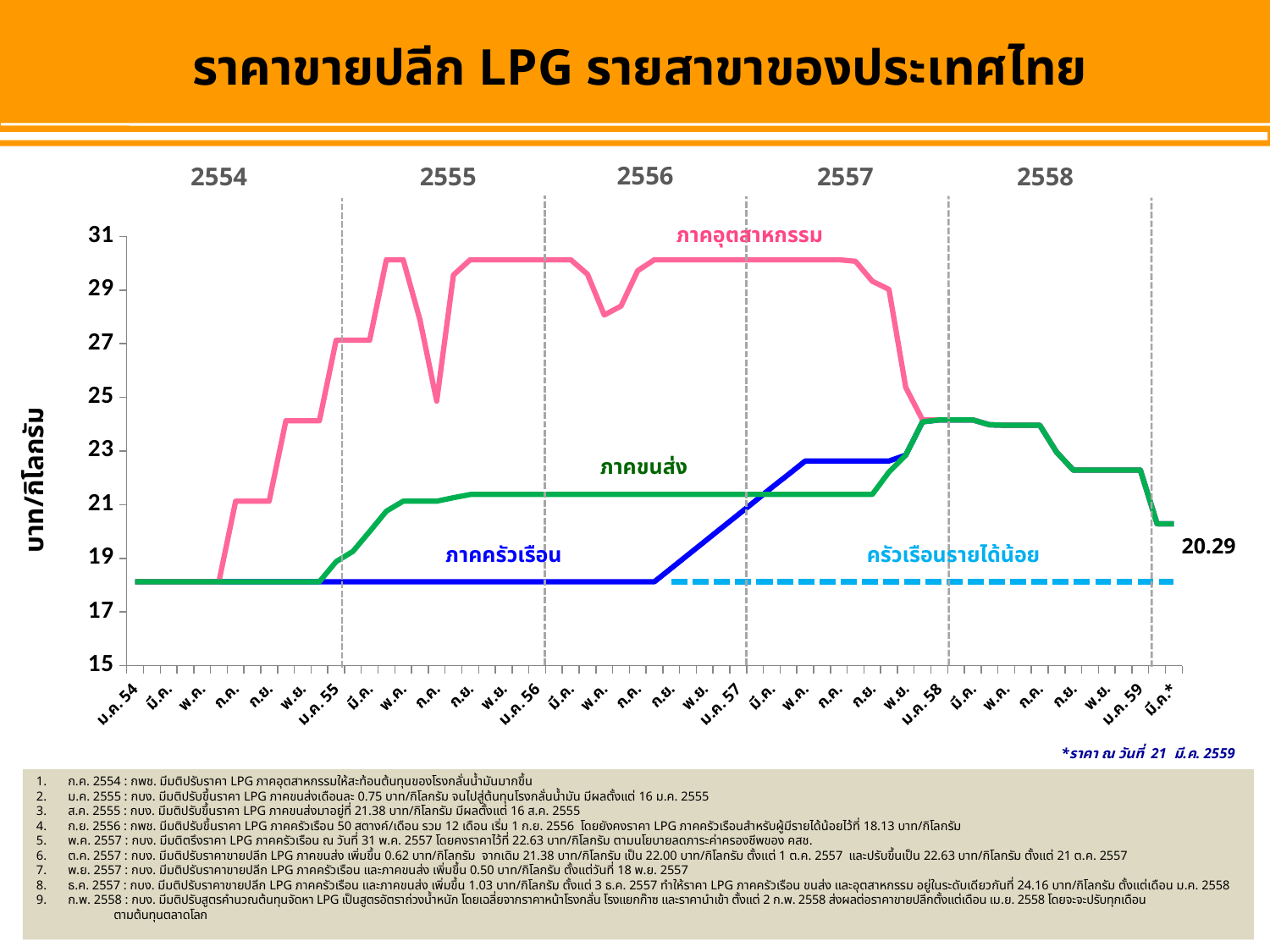
Is the value for ภาคครัวเรือน during 2555 greater or less than 19? less What is the title of the chart? ราคาขายปลีก LPG รายสาขาของประเทศไทย What value is printed as a data label at the right end of the chart? 20.29 What is the label on the vertical axis? บาท/กิโลกรัม Does the ภาคครัวเรือน line rise or fall between late 2556 and mid 2557? rise Is the value for ภาคขนส่ง during 2556 greater or less than 23? less What kind of chart is shown on the slide? line chart Which sector line is the lowest during 2555? ภาคครัวเรือน Does the ภาคอุตสาหกรรม line rise or fall between late 2557 and early 2558? fall Which sector line is the highest during 2555? ภาคอุตสาหกรรม How many sector lines are labelled on the chart? 4